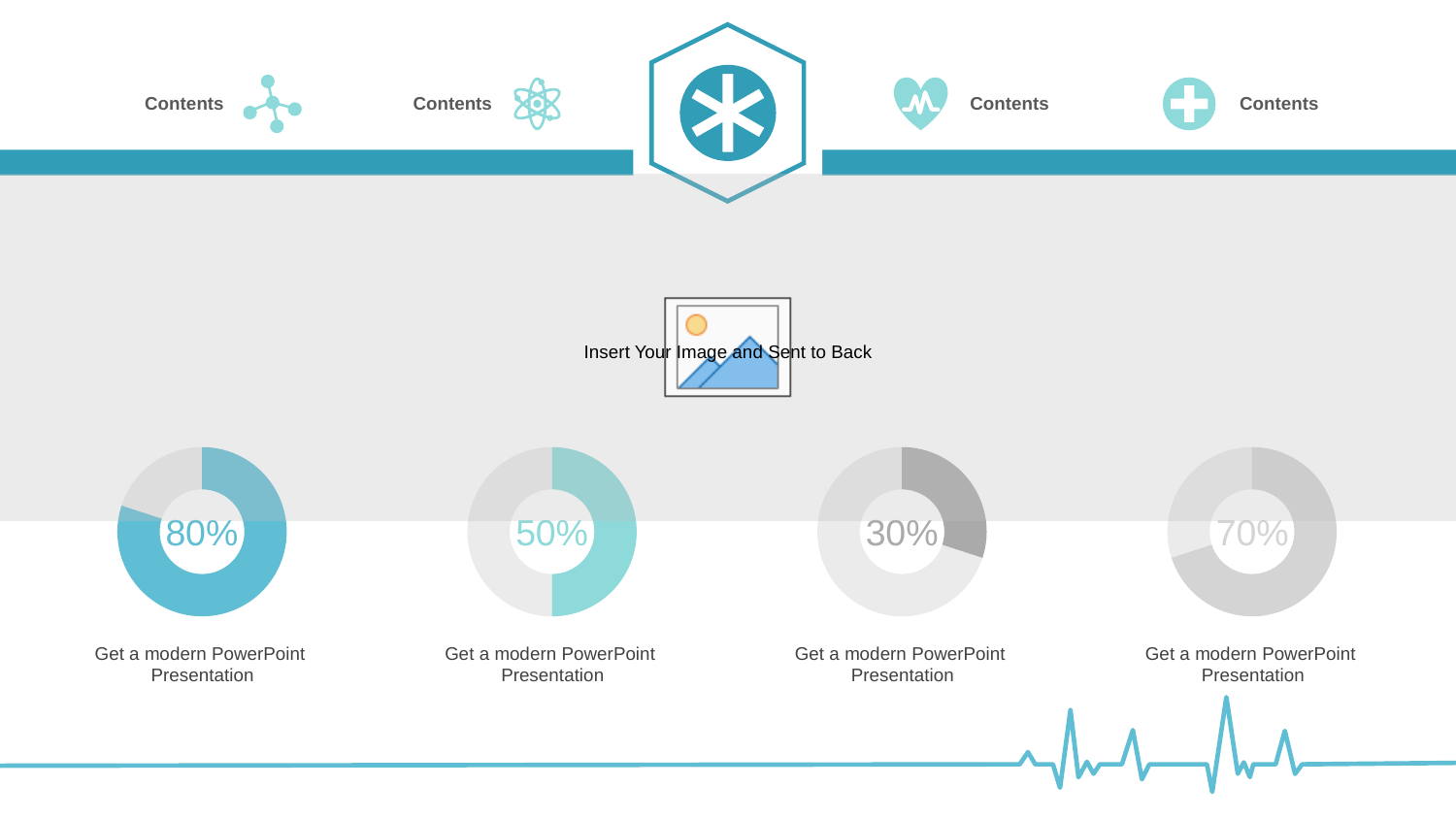
What colour is the filled portion of the leftmost donut chart? Blue How many donut charts are on the slide? 4 What percentage is shown in the leftmost donut chart? 80% What percentage is shown in the second donut chart from the left? 50% What percentage is shown in the third donut chart from the left? 30% Which donut chart shows the lowest percentage? The third from the left (30%) Which shows a larger percentage, the second donut chart from the left or the rightmost donut chart? The rightmost donut chart What is the difference between the percentage in the second donut chart and the percentage in the third donut chart? 20% Which donut chart shows the highest percentage? The leftmost one (80%) What is the difference between the percentage in the leftmost donut chart and the percentage in the rightmost donut chart? 10% What kind of chart is used to display the percentages on the slide? Donut chart What percentage is shown in the rightmost donut chart? 70%